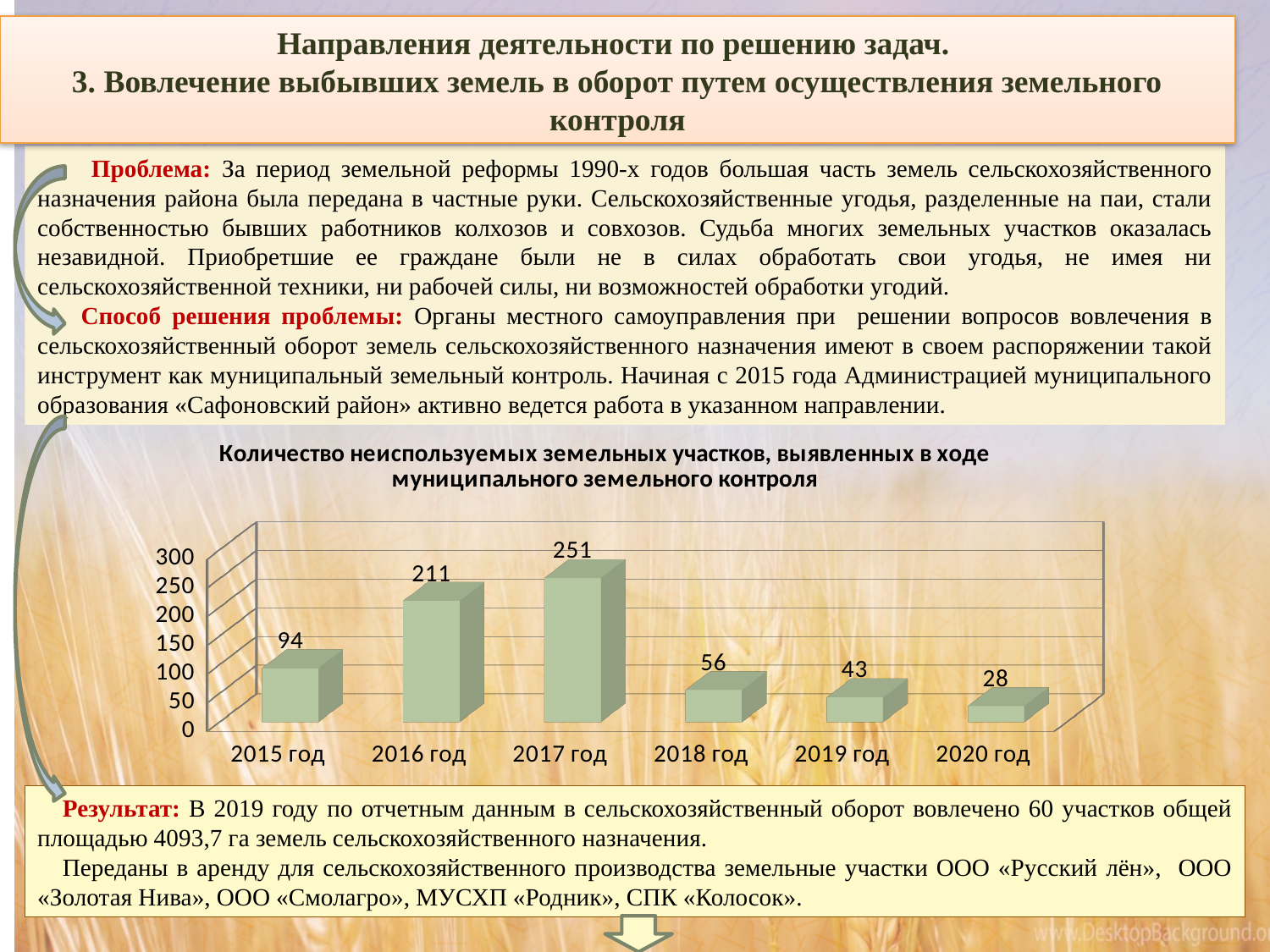
Is the value for 2016 год greater or less than 200? greater Which year has the highest value? 2017 год What kind of chart is shown on the slide? bar chart What is the difference between the values for 2018 год and 2019 год? 13 What is the value for 2017 год? 251 Which year has the lowest value? 2020 год What is the value for 2020 год? 28 Do the values rise or fall from 2017 год to 2020 год? fall How many years are shown on the x axis? 6 What is the difference between the values for 2017 год and 2016 год? 40 What is the value for 2015 год? 94 Which is larger, the value for 2015 год or the value for 2018 год? 2015 год